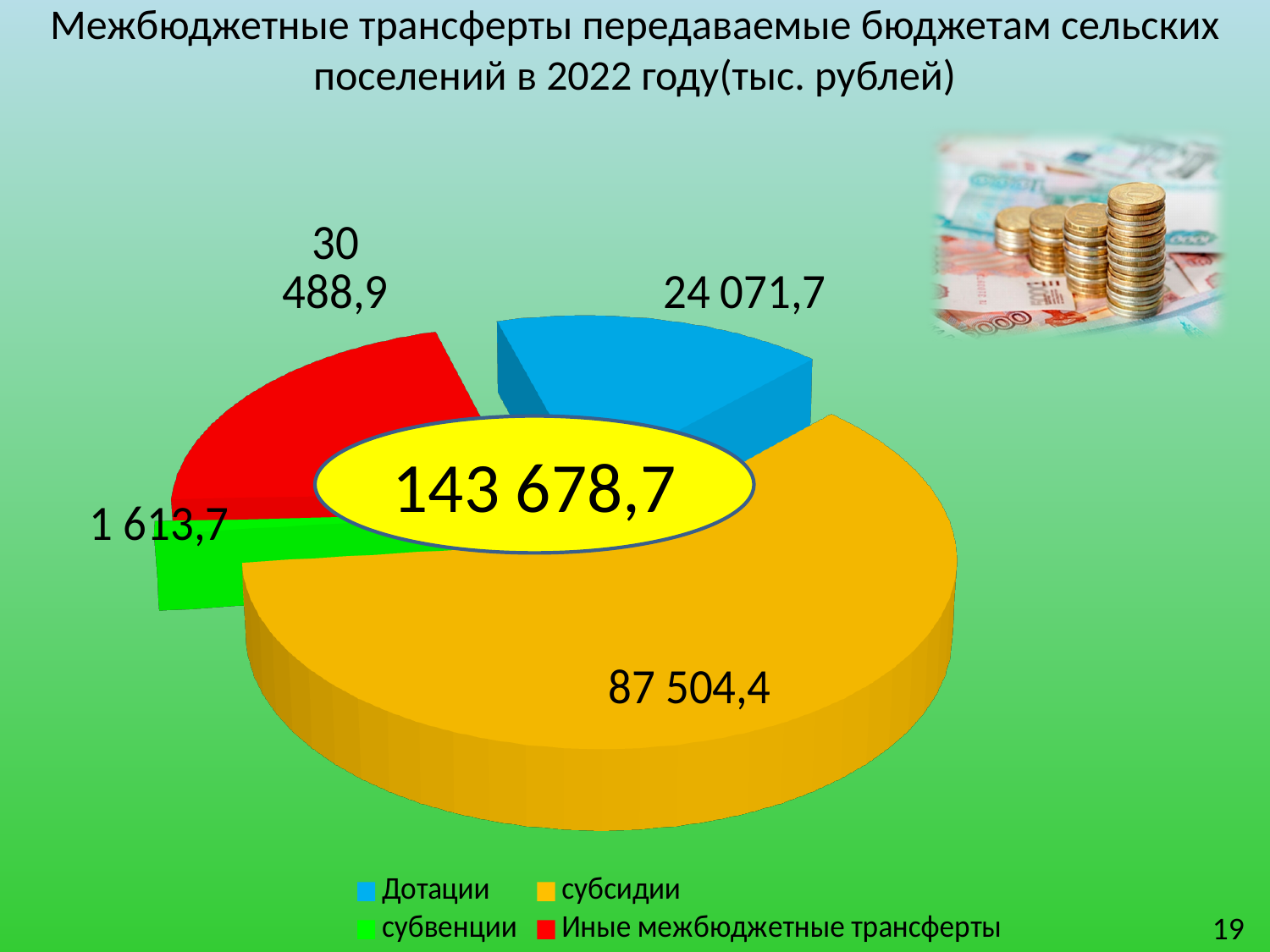
What is the value for Дотации? 24 071,7 How many slices does the pie chart have? 4 What total value is shown in the centre of the pie chart? 143 678,7 Which category has the largest slice of the pie? субсидии What is the value for субвенции? 1 613,7 Which category has the smallest slice of the pie? субвенции What is the difference between субсидии and Иные межбюджетные трансферты? 57 015,5 Which is larger: Дотации or Иные межбюджетные трансферты? Иные межбюджетные трансферты What kind of chart is shown on the slide? pie chart What is the value for Иные межбюджетные трансферты? 30 488,9 What colour is the slice for субвенции? green What is the value for субсидии? 87 504,4